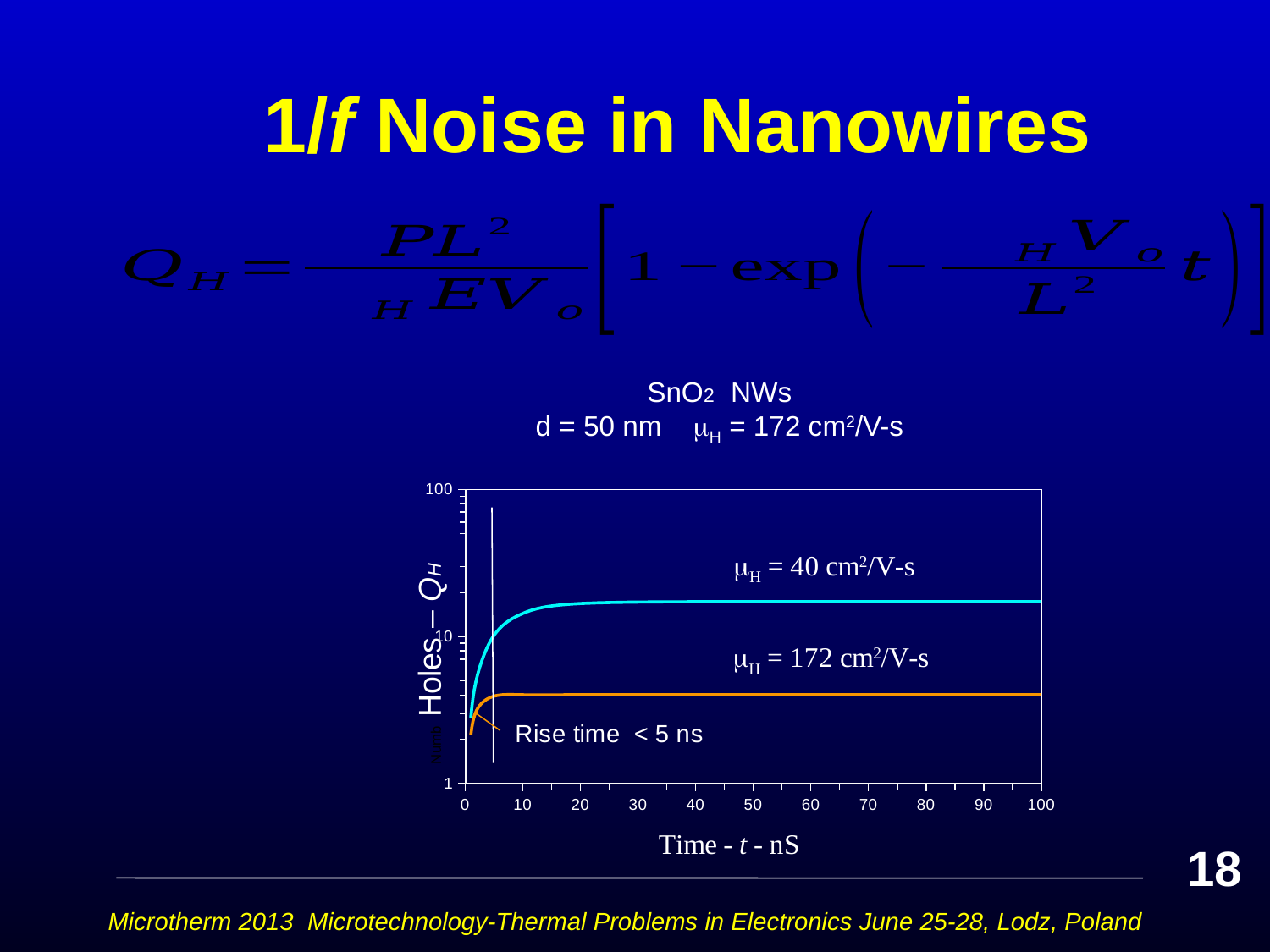
Which curve plateaus at a higher value of Q_H: the one for μH = 40 cm²/V-s or the one for μH = 172 cm²/V-s? μH = 40 cm²/V-s What is the maximum value shown on the x axis of the chart? 100 What is the label of the x axis of the chart? Time - t - nS What is the lowest tick value shown on the y axis of the chart? 1 What kind of chart is shown on the slide? line chart How many curves are plotted on the chart? 2 How does the μH = 172 cm²/V-s curve behave as time increases along the x axis? rises quickly then stays flat Is the plateau value of the μH = 40 cm²/V-s curve greater or less than 100? less Is the plateau value of the μH = 40 cm²/V-s curve greater or less than 10? greater What rise time is annotated on the chart? < 5 ns Is the plateau value of the μH = 172 cm²/V-s curve greater or less than 10? less